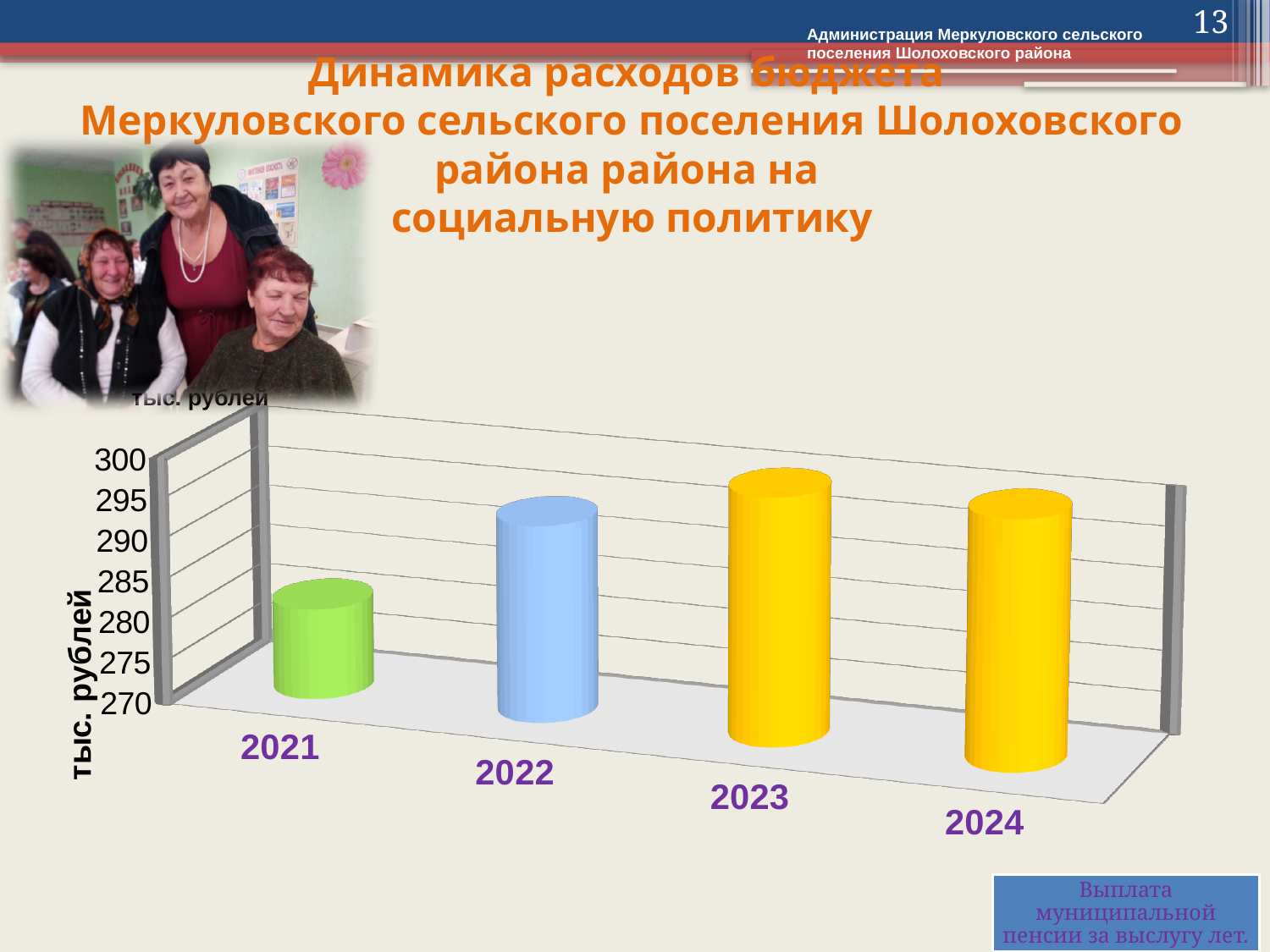
How many years are shown on the x axis of the chart? 4 What unit is given on the vertical axis of the chart? тыс. рублей Is the value for 2021 greater or less than 275? greater Which year has the lowest value in the chart? 2021 Is the value for 2021 greater or less than 290? less Which is larger, the value for 2022 or the value for 2023? 2023 Is the value for 2023 greater or less than 290? greater Does the value rise or fall from 2021 to 2022? rise Which is larger, the value for 2021 or the value for 2024? 2024 What kind of chart is shown on the slide? bar chart Which is larger, the value for 2021 or the value for 2022? 2022